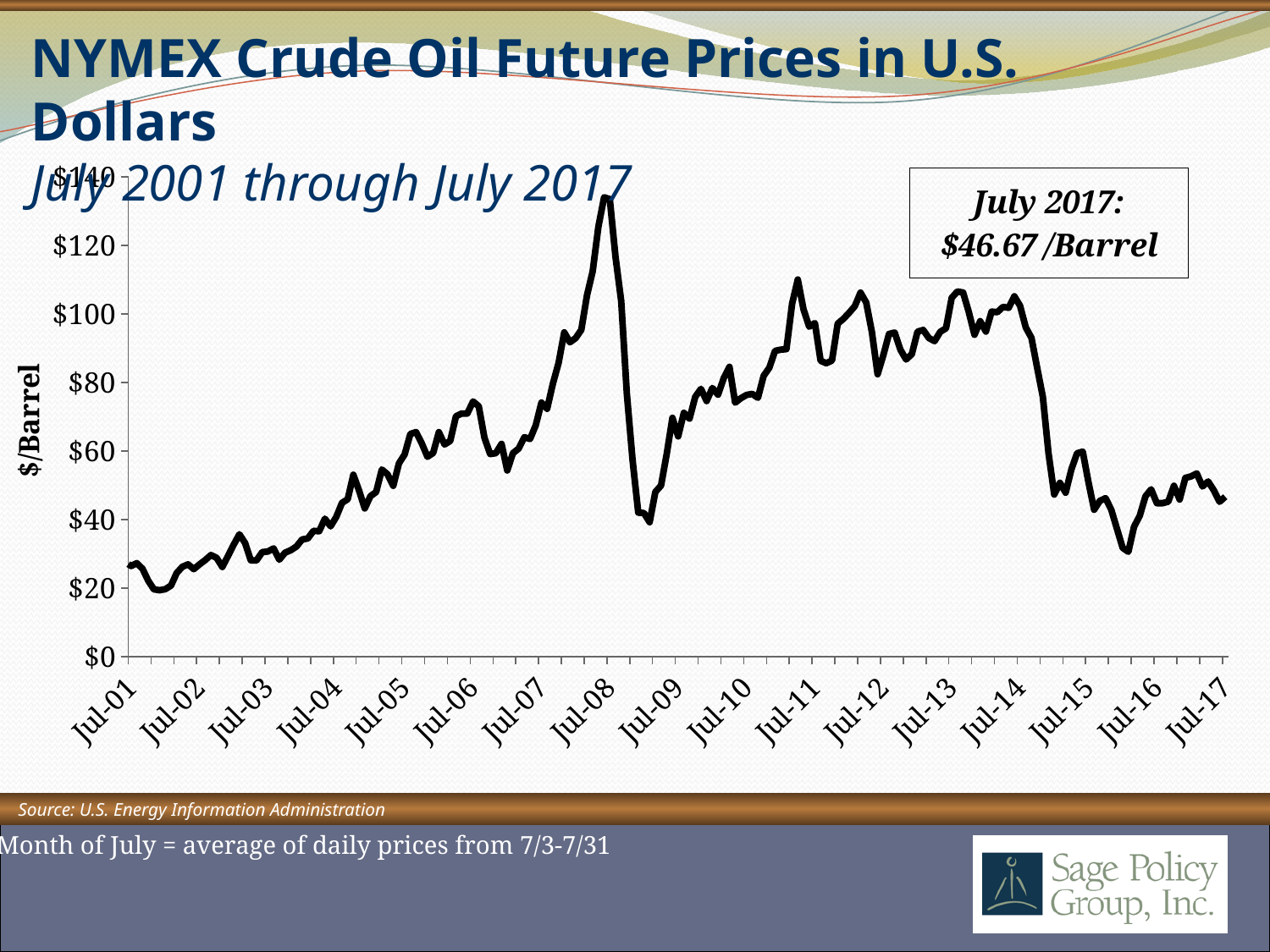
Does the crude oil price rise or fall between Jul-14 and Jul-15? fall Around which x-axis label does the crude oil price reach its highest point? Jul-08 Is the value at Jul-01 greater or less than $40? less Is the value at Jul-16 greater or less than $60? less What kind of chart is shown on the slide? line chart What is the label on the vertical axis of the chart? $/Barrel How many labels are shown on the x axis of the chart? 17 Is the value at Jul-11 greater or less than $80? greater Does the crude oil price generally rise or fall between Jul-01 and Jul-08? rise What is the NYMEX crude oil future price for July 2017 according to the annotation on the chart? $46.67/Barrel